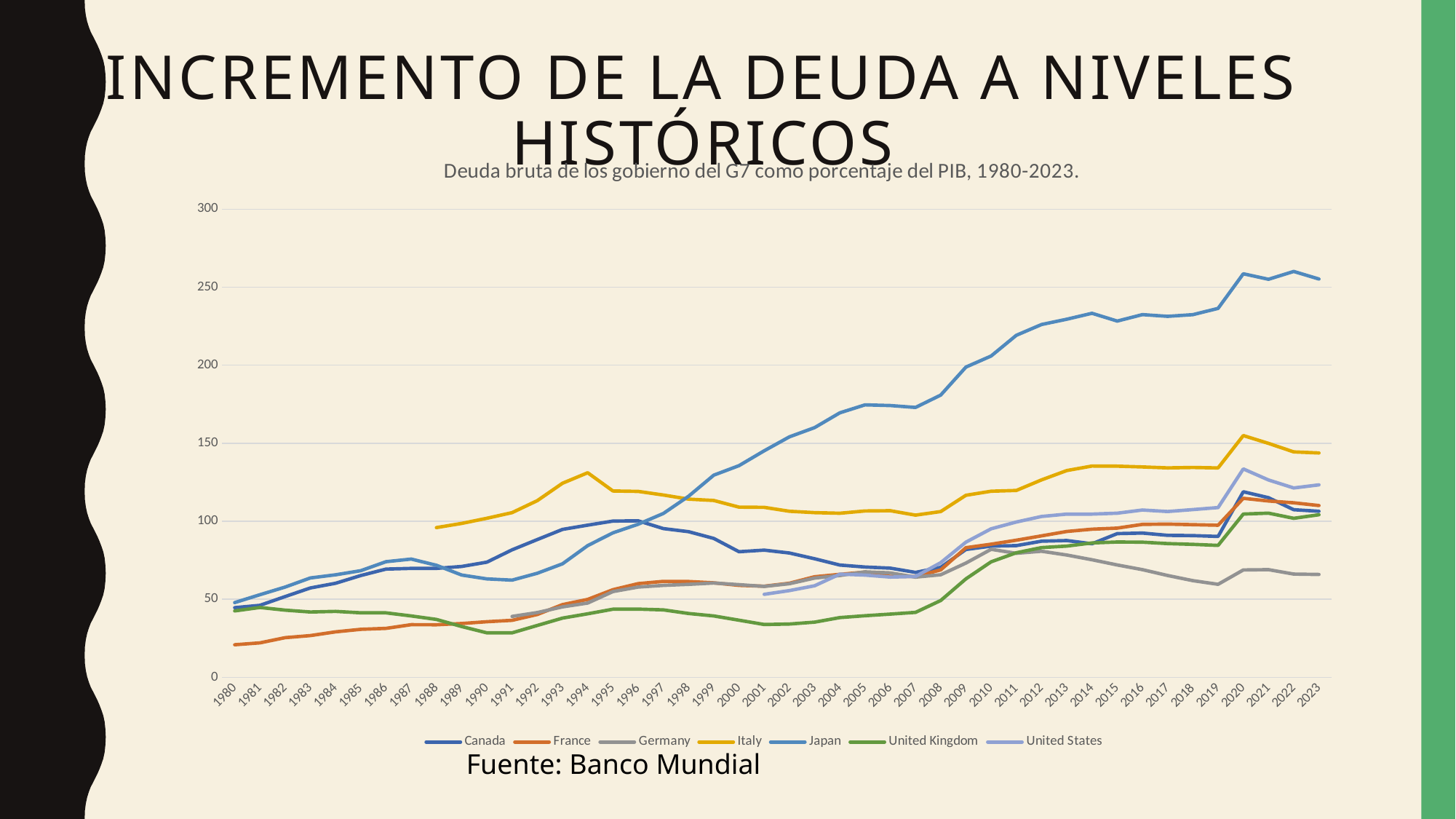
How many years are shown along the x axis? 44 Which country has the highest value in 1994? Italy How many series does the legend list? 7 What kind of chart is shown on the slide? line chart What is the title of the chart? Deuda bruta de los gobierno del G7 como porcentaje del PIB, 1980-2023. In 2023, which is larger, the value for the United Kingdom or the value for Germany? United Kingdom Is the value for Germany in 2023 greater or less than 100? less Is the value for Japan in 2023 greater or less than 200? greater Which country has the highest debt-to-GDP value in 2023? Japan Does the value for Japan generally rise or fall from 1980 to 2023? rise Which country has the lowest debt-to-GDP value in 2023? Germany Which country has the lowest value in 1980? France